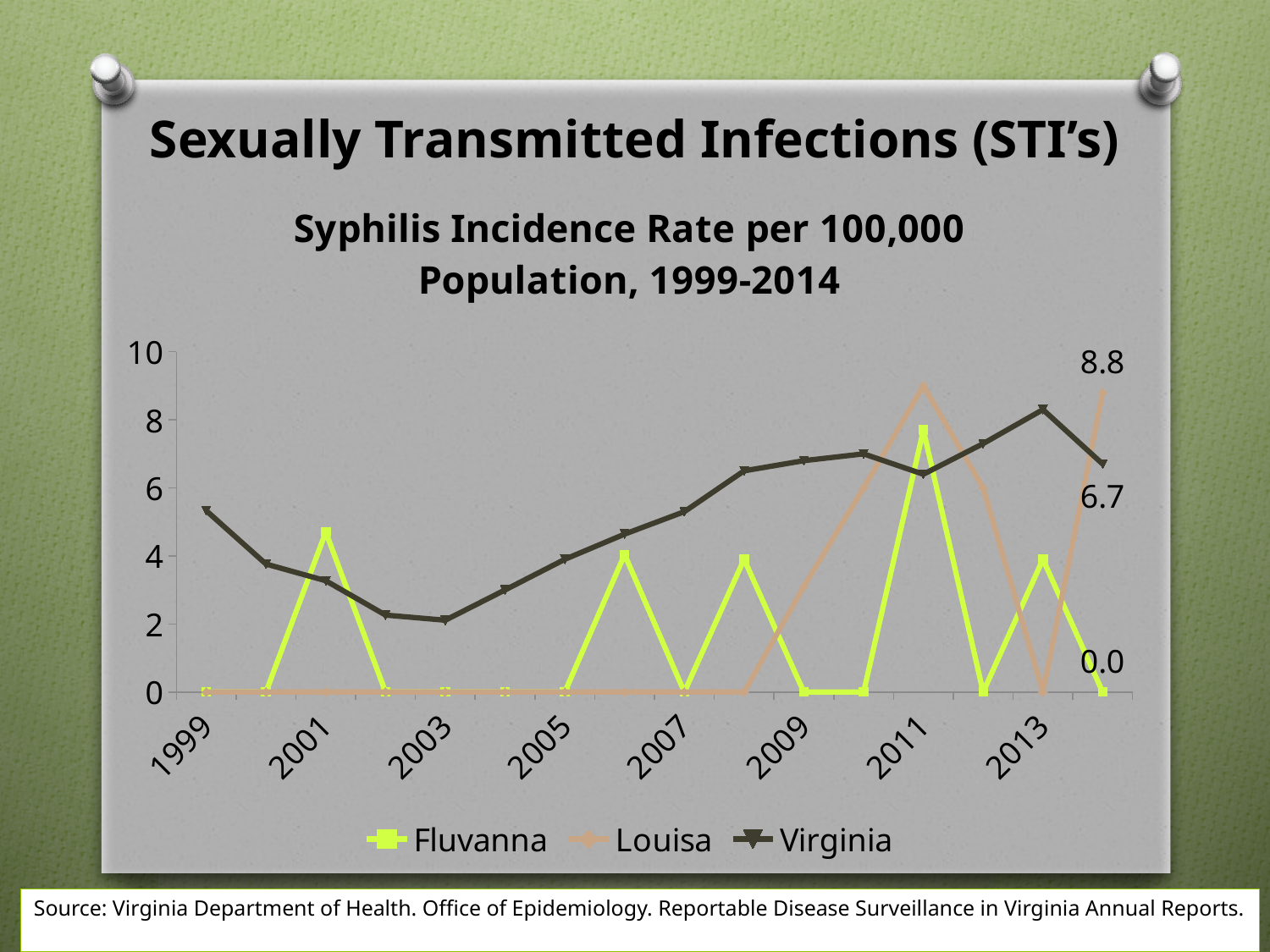
What is the difference between the Louisa and Virginia values in 2014? 2.1 In 2014, which is larger, the value for Louisa or the value for Virginia? Louisa Is the value for Virginia in 2003 greater or less than 4? less What is the value for Louisa in 2014? 8.8 Which series has the highest value in 2014? Louisa Which series has the lowest value in 2014? Fluvanna What is the value for Fluvanna in 2014? 0.0 What is the value for Virginia in 2014? 6.7 What kind of chart is shown on the slide? Line chart Is the value for Louisa in 2011 greater or less than 8? greater Does the Virginia line rise or fall between 2003 and 2013? Rise How many series does the legend list? 3